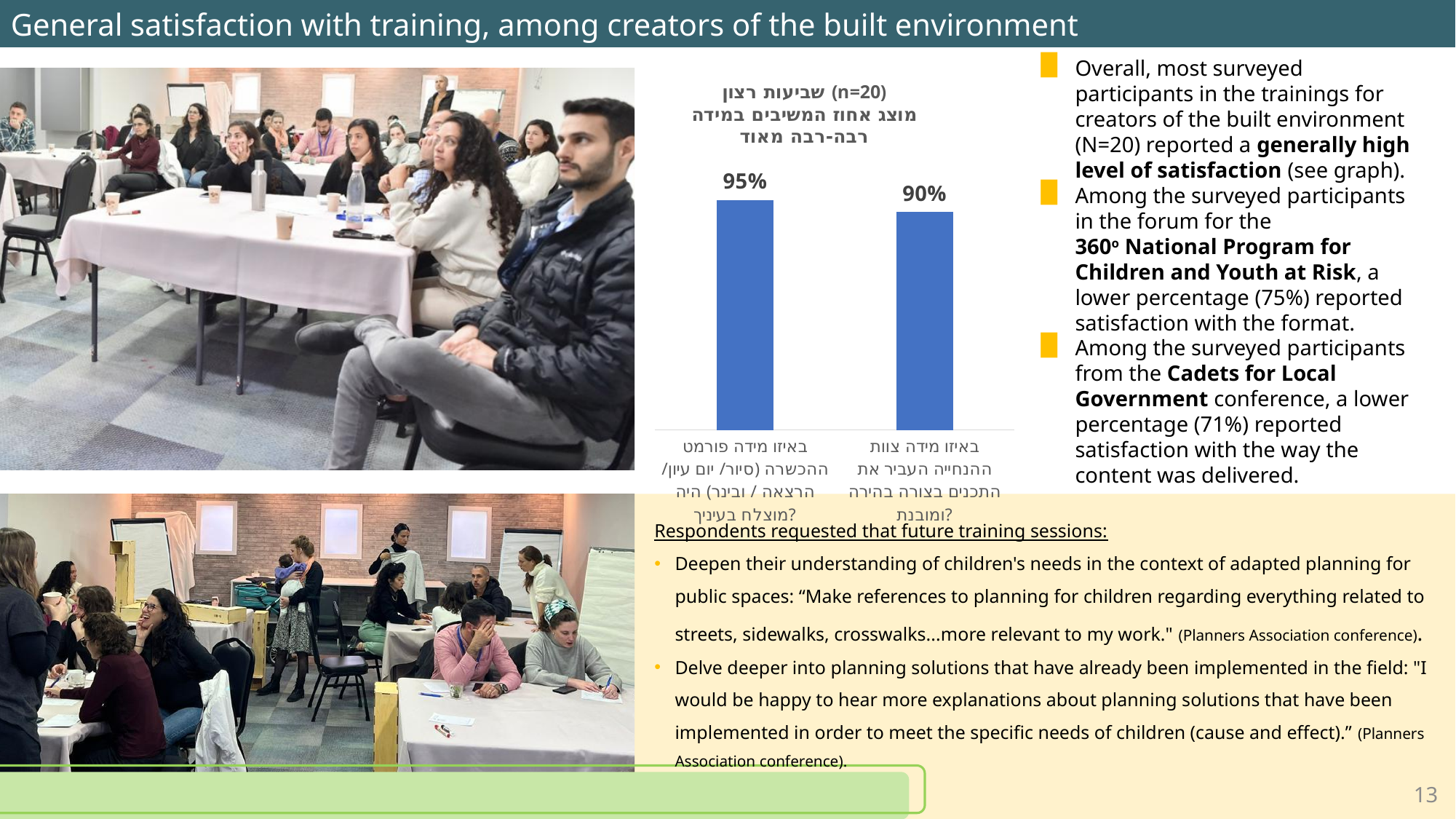
What colour are the bars in the chart? blue What is the difference between the two bar values in the chart? 5% Do the values fall or rise from the left bar to the right bar? fall What type of chart is shown on the slide? bar chart What sample size (n) is stated in the chart title? n=20 What is the value of the right bar in the chart (the question about the facilitation team conveying content clearly)? 90% How many bars does the chart show? 2 What is the value of the left bar in the chart (the question about the training format)? 95% Which bar in the chart is higher, the left one or the right one? the left one Which category has the lowest value in the chart? the right bar (facilitation team conveyed content clearly)